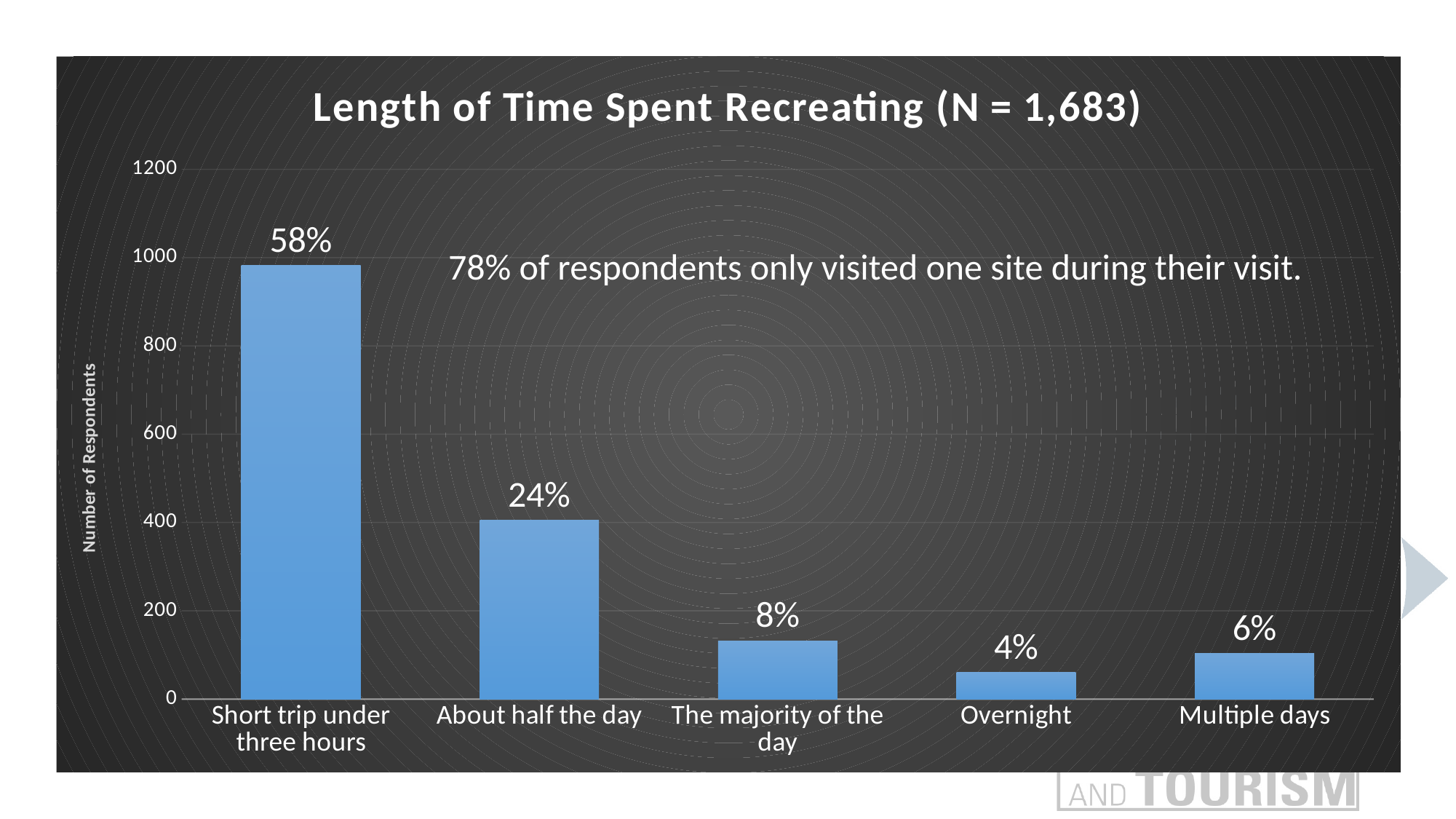
What percentage label is shown for the 'Short trip under three hours' bar? 58% What percentage label is shown for the 'Overnight' bar? 4% Which category has the highest number of respondents? Short trip under three hours What is the difference in percentage points between the 'Short trip under three hours' and 'About half the day' labels? 34 percentage points Which category has the lowest number of respondents? Overnight Is the number of respondents for 'Short trip under three hours' greater or less than 800? greater What percentage label is shown for the 'About half the day' bar? 24% What type of chart is shown on the slide? Bar chart Which has more respondents, 'Overnight' or 'Multiple days'? Multiple days How many categories are shown on the x axis? 5 Is the number of respondents for 'The majority of the day' greater or less than 200? less What percentage label is shown for the 'Multiple days' bar? 6%